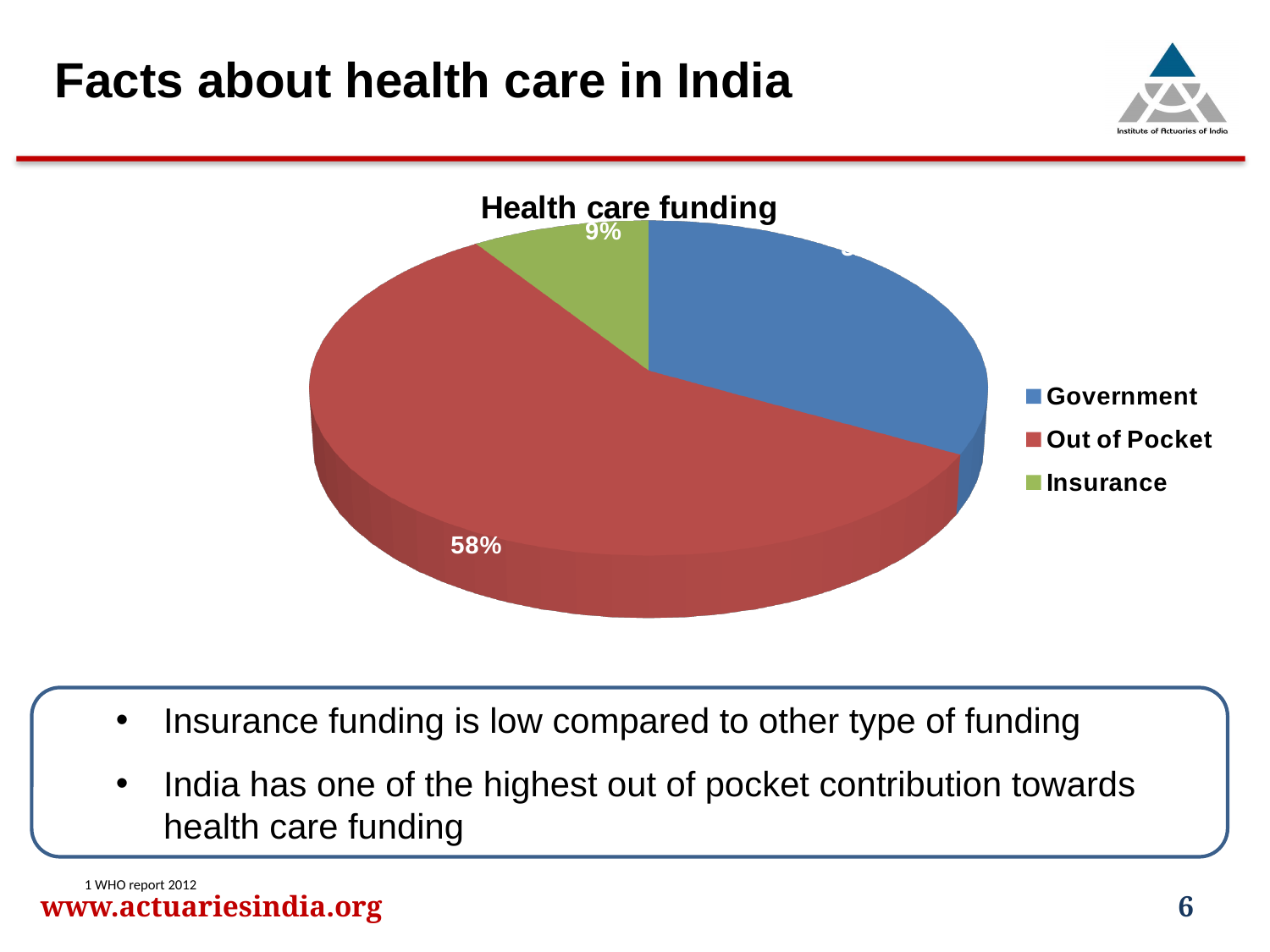
Which funding source has the largest slice of the pie? Out of Pocket What is the difference in percentage points between the Out of Pocket share and the Insurance share? 49 percentage points What colour is the Out of Pocket slice in the pie chart? Red How many categories does the legend list? 3 Which is larger, the Out of Pocket slice or the Government slice? Out of Pocket What share of health care funding comes from Out of Pocket? 58% What is the title of the chart? Health care funding What type of chart is shown on the slide? Pie chart Which funding source has the smallest slice of the pie? Insurance Which is larger, the Government slice or the Insurance slice? Government What share of health care funding comes from Insurance? 9%